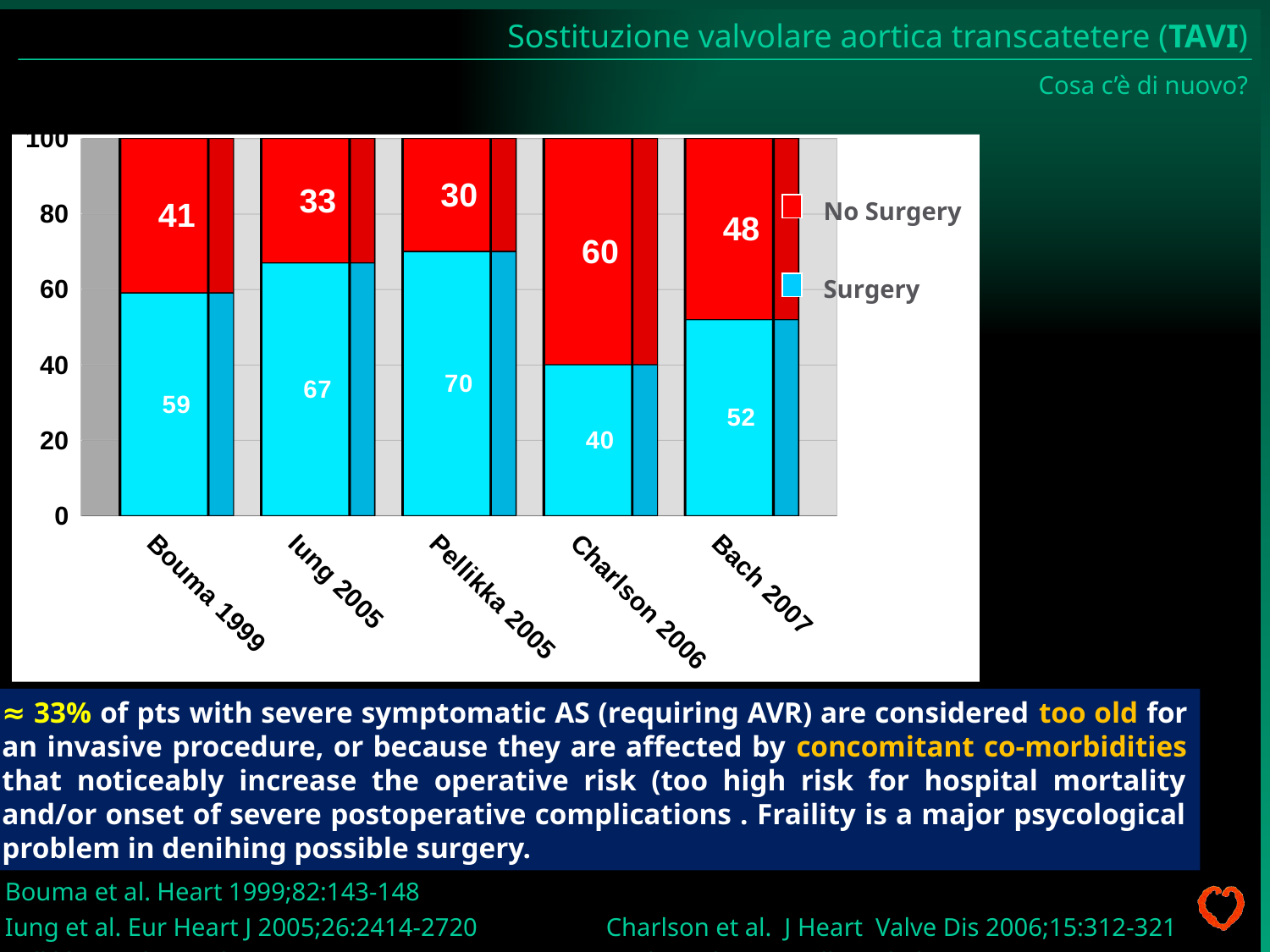
What kind of chart is shown? Stacked bar chart How many series does the legend list? 2 What is the Surgery value for Bach 2007? 52 Which is larger, the No Surgery value for Bach 2007 or for Bouma 1999? Bach 2007 Which study has the highest No Surgery value? Charlson 2006 How many studies are shown on the x axis? 5 What is the Surgery value for Pellikka 2005? 70 What is the difference between the Surgery values for Iung 2005 and Bouma 1999? 8 Which study has the lowest Surgery value? Charlson 2006 What is the total of the stacked bar for Charlson 2006? 100 Which study has the highest Surgery value? Pellikka 2005 What is the No Surgery value for Charlson 2006? 60